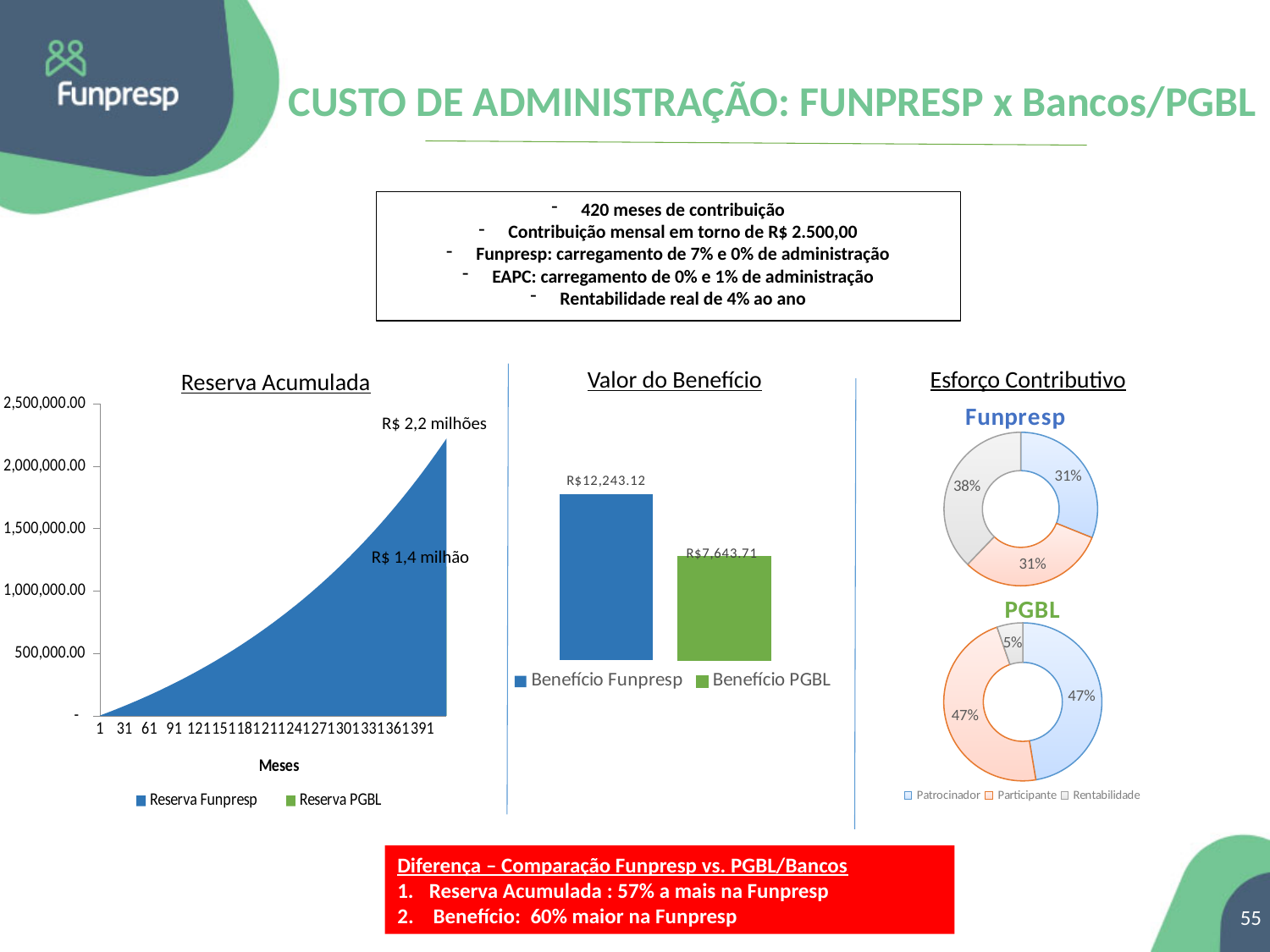
In the PGBL donut chart under 'Esforço Contributivo', which category has the smallest share? Rentabilidade How many series does the legend of the 'Reserva Acumulada' chart list? 2 In the PGBL donut chart under 'Esforço Contributivo', what share is Rentabilidade? 5% What kind of chart is the 'Valor do Benefício' chart? Bar chart In the 'Reserva Acumulada' chart, what value is labelled for the PGBL reserve? R$ 1,4 milhão In the 'Valor do Benefício' chart, which benefit is larger, Benefício Funpresp or Benefício PGBL? Benefício Funpresp In the 'Reserva Acumulada' chart, what value is labelled at the top of the Funpresp reserve curve? R$ 2,2 milhões In the Funpresp donut chart under 'Esforço Contributivo', what share is Rentabilidade? 38% In the 'Valor do Benefício' chart, what is the value for Benefício PGBL? R$7,643.71 In the 'Reserva Acumulada' chart, does the accumulated reserve rise or fall as the months increase? Rise In the 'Valor do Benefício' chart, what is the value for Benefício Funpresp? R$12,243.12 In the 'Valor do Benefício' chart, what is the difference between Benefício Funpresp and Benefício PGBL? R$4,599.41